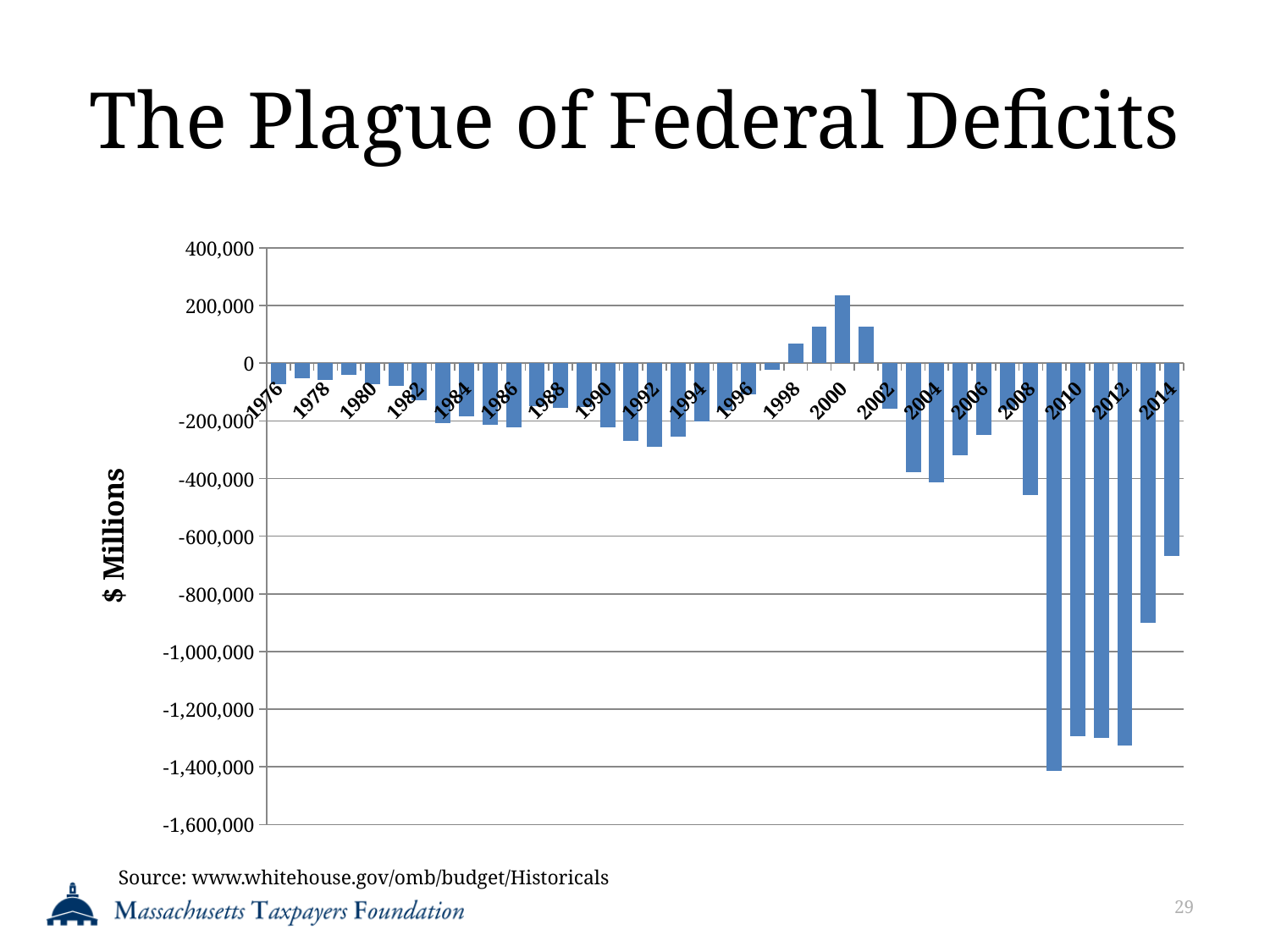
What is the label on the vertical axis of the chart? $ Millions What kind of chart is shown on the slide? bar chart Do the values rise or fall from 2009 to 2014? rise Which year has the larger value, 2009 or 2014? 2014 Is the value for 1998 greater or less than 0? greater Is the value for 2014 greater or less than -600,000? less Is the value for 1992 greater or less than -200,000? less Which year has the lowest value on the chart? 2009 What is the title of the chart on the slide? The Plague of Federal Deficits Which year has the highest value on the chart? 2000